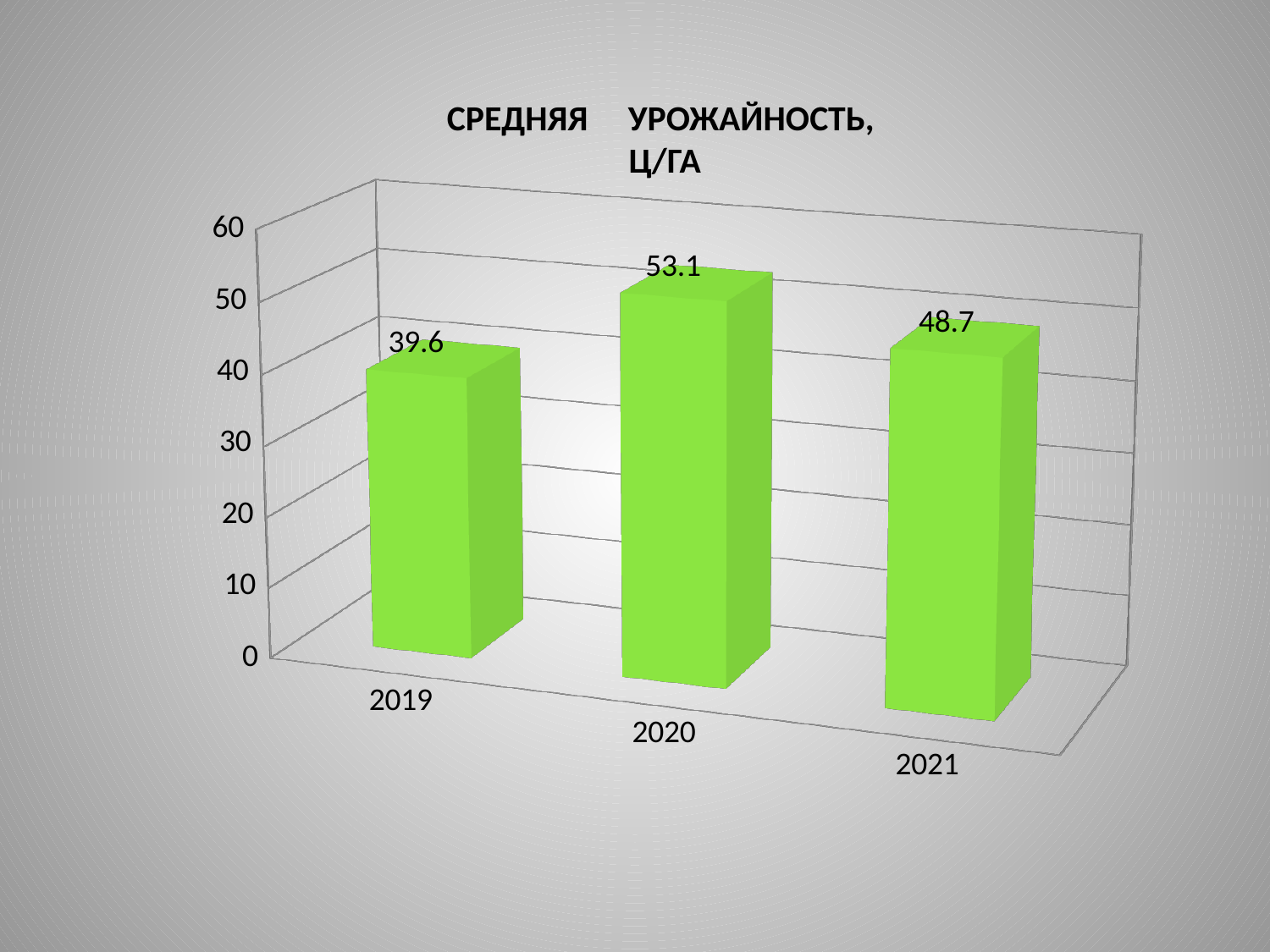
What is the average yield value shown for 2020? 53.1 How many years are shown on the chart? 3 Which is larger, the value for 2021 or the value for 2019? 2021 What is the title of the chart? СРЕДНЯЯ УРОЖАЙНОСТЬ, Ц/ГА Which year has the lowest average yield? 2019 Is the value for 2020 greater or less than 50? greater What kind of chart is shown on the slide? bar chart What is the difference between the 2020 and 2021 values? 4.4 What is the average yield value shown for 2021? 48.7 What is the average yield value shown for 2019? 39.6 Which year has the highest average yield? 2020 What is the difference between the 2020 and 2019 values? 13.5